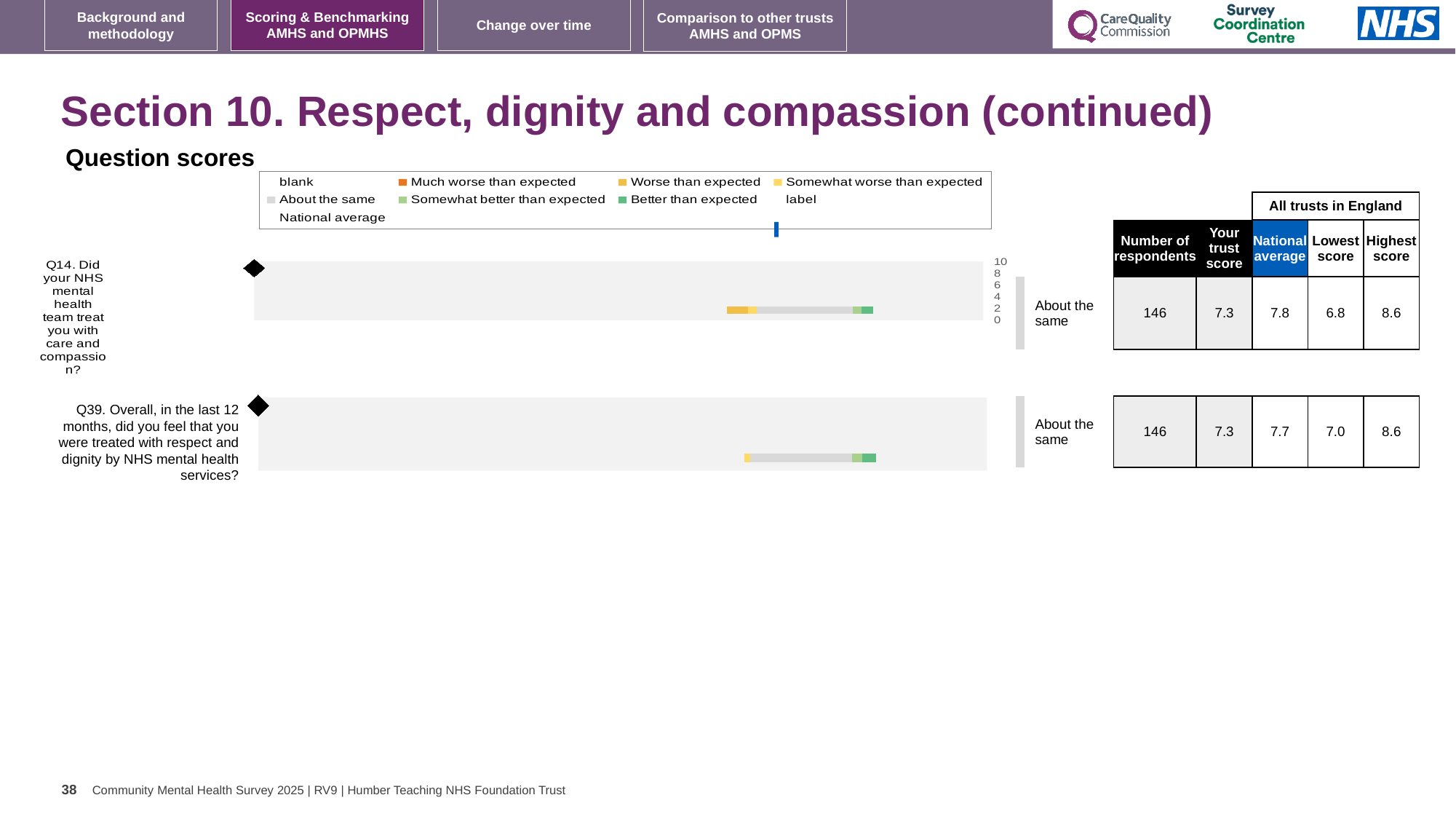
What is the lowest score among all trusts in England for Q39? 7.0 What kind of chart is used to show the question scores for Q14 and Q39? bar chart What is the highest score among all trusts in England for Q39? 8.6 For Q39, which is larger: the trust score or the national average? national average How many respondents answered Q14? 146 How many questions are plotted in the question scores chart? 2 What is the trust score for Q14 (care and compassion)? 7.3 What is the difference between the national average and the trust score for Q14? 0.5 What colour does the legend use for 'Better than expected'? green What is the national average score for Q14? 7.8 What is the difference between the highest and lowest scores for Q39? 1.6 What benchmark category label is shown next to the Q14 bar? About the same